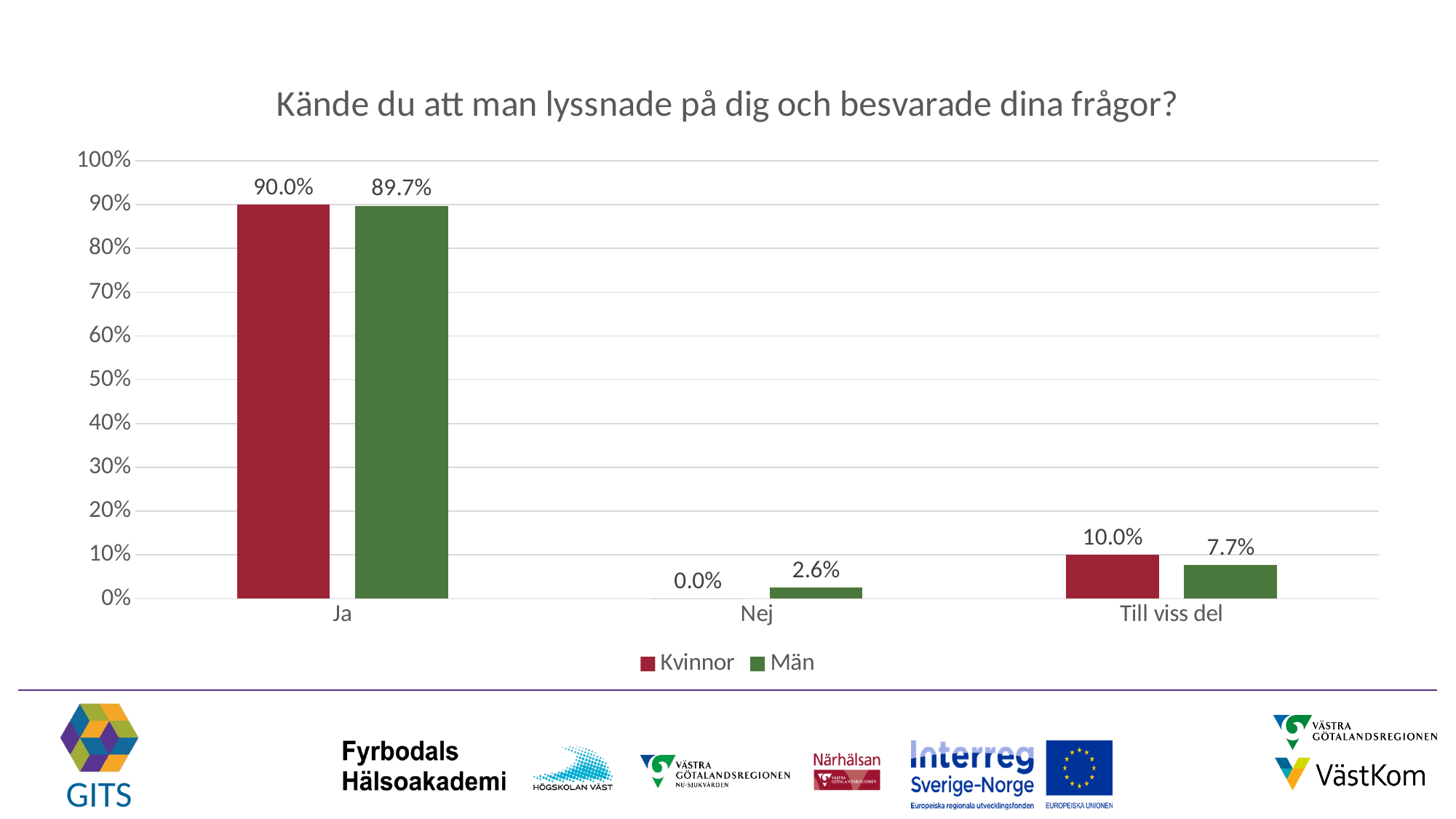
How many categories are shown on the x axis? 3 What is the value for Kvinnor in the Till viss del category? 10.0% What is the value for Kvinnor in the Ja category? 90.0% Which category has the lowest value for Män? Nej What is the value for Män in the Till viss del category? 7.7% What kind of chart is shown on the slide? Bar chart What is the value for Kvinnor in the Nej category? 0.0% What is the difference between the Kvinnor and Män values in the Till viss del category? 2.3% How many series does the legend list? 2 Which category has the highest value for Kvinnor? Ja What is the value for Män in the Ja category? 89.7% What is the value for Män in the Nej category? 2.6%